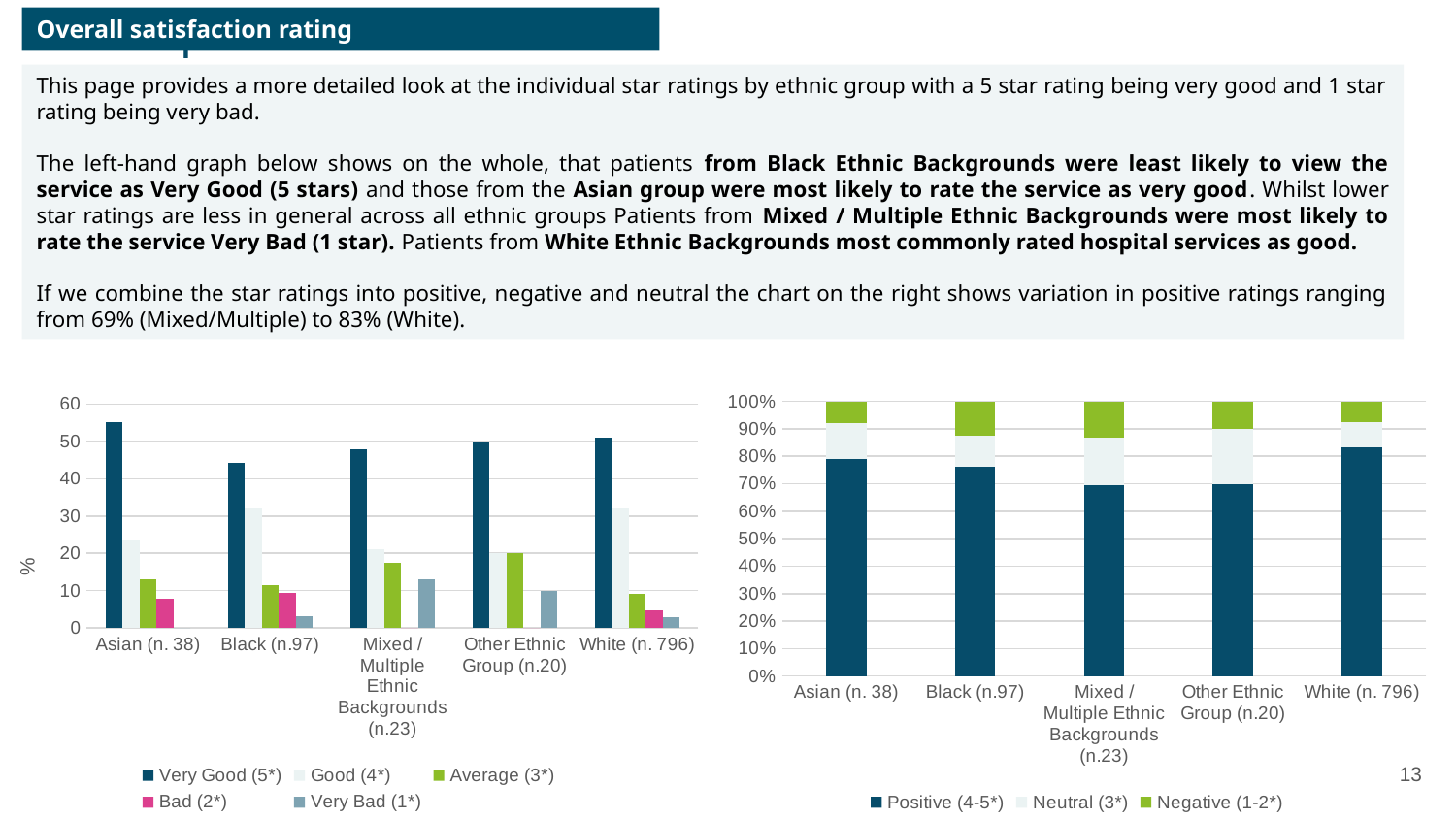
What type of chart is the left-hand chart on the slide? bar chart How many ethnic group categories are shown on the x axis of the left-hand chart? 5 In the left-hand chart, which is larger: the Good (4*) value for Black (n.97) or the Good (4*) value for Asian (n. 38)? Black (n.97) How many series does the legend of the left-hand chart list? 5 In the right-hand chart, which ethnic group has the largest Positive (4-5*) segment? White (n. 796) In the left-hand chart, is the Very Bad (1*) value for Mixed / Multiple Ethnic Backgrounds (n.23) greater or less than 10? greater In the right-hand chart, is the Positive (4-5*) value for Black (n.97) greater or less than 80%? less In the left-hand chart, which ethnic group has the highest Very Good (5*) bar? Asian (n. 38) In the left-hand chart, is the Very Good (5*) value for Black (n.97) greater or less than 50? less What type of chart is the right-hand chart on the slide? stacked bar chart How many series does the legend of the right-hand chart list? 3